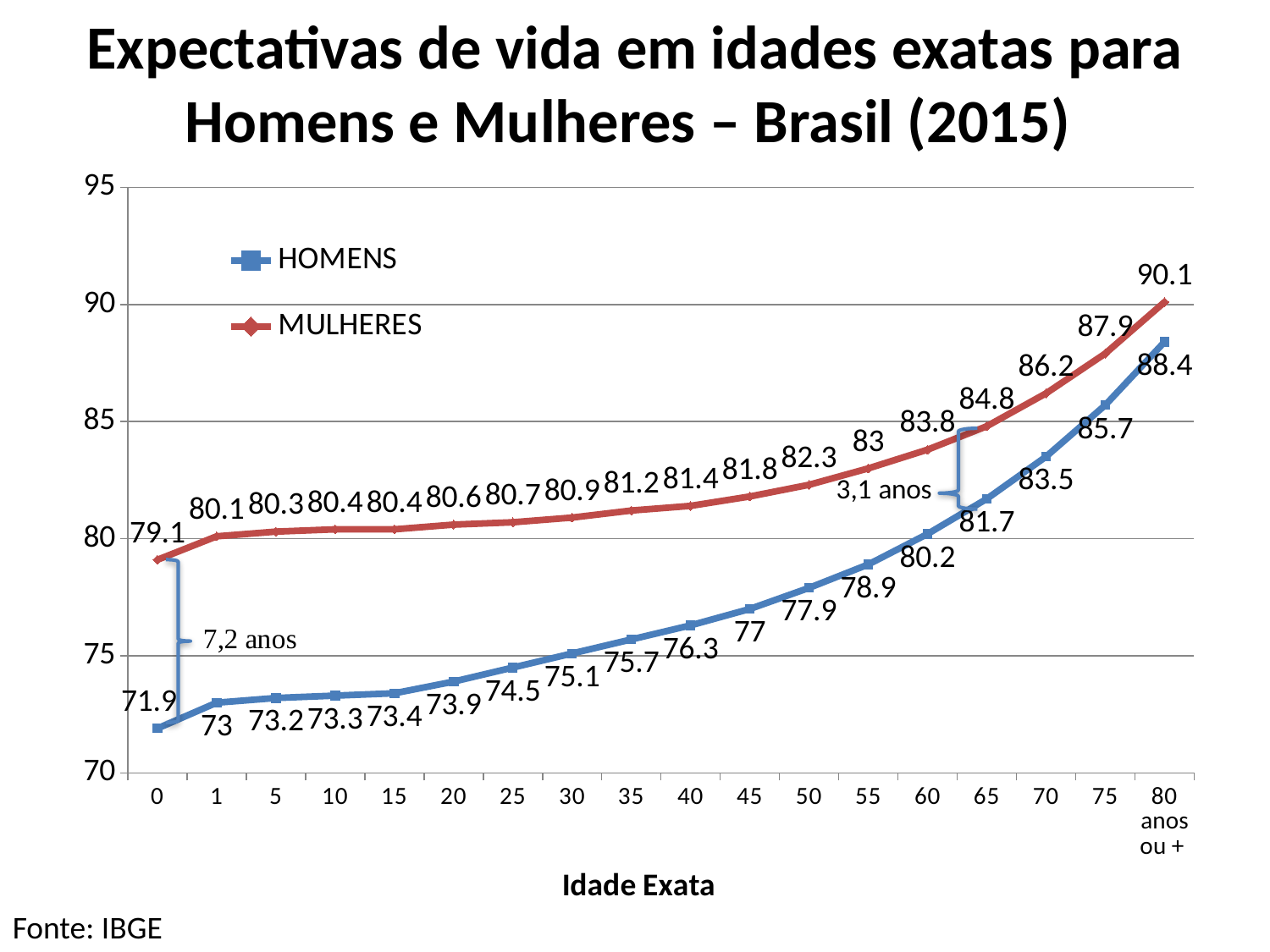
What is the value for MULHERES at exact age 40? 81.4 What is the value for HOMENS at exact age 60? 80.2 What kind of chart is shown on the slide? Line chart What is the life expectancy for HOMENS at exact age 0? 71.9 At which exact age is the HOMENS series highest? 80 anos ou + How many exact-age points are plotted on the x axis? 18 Which series has the higher value at exact age 20, HOMENS or MULHERES? MULHERES Do the HOMENS values rise or fall as exact age increases along the x axis? Rise What is the difference between MULHERES and HOMENS at exact age 65? 3.1 What is the life expectancy for MULHERES at exact age 80 anos ou +? 90.1 How many series does the legend list? 2 At which exact age is the MULHERES series lowest? 0